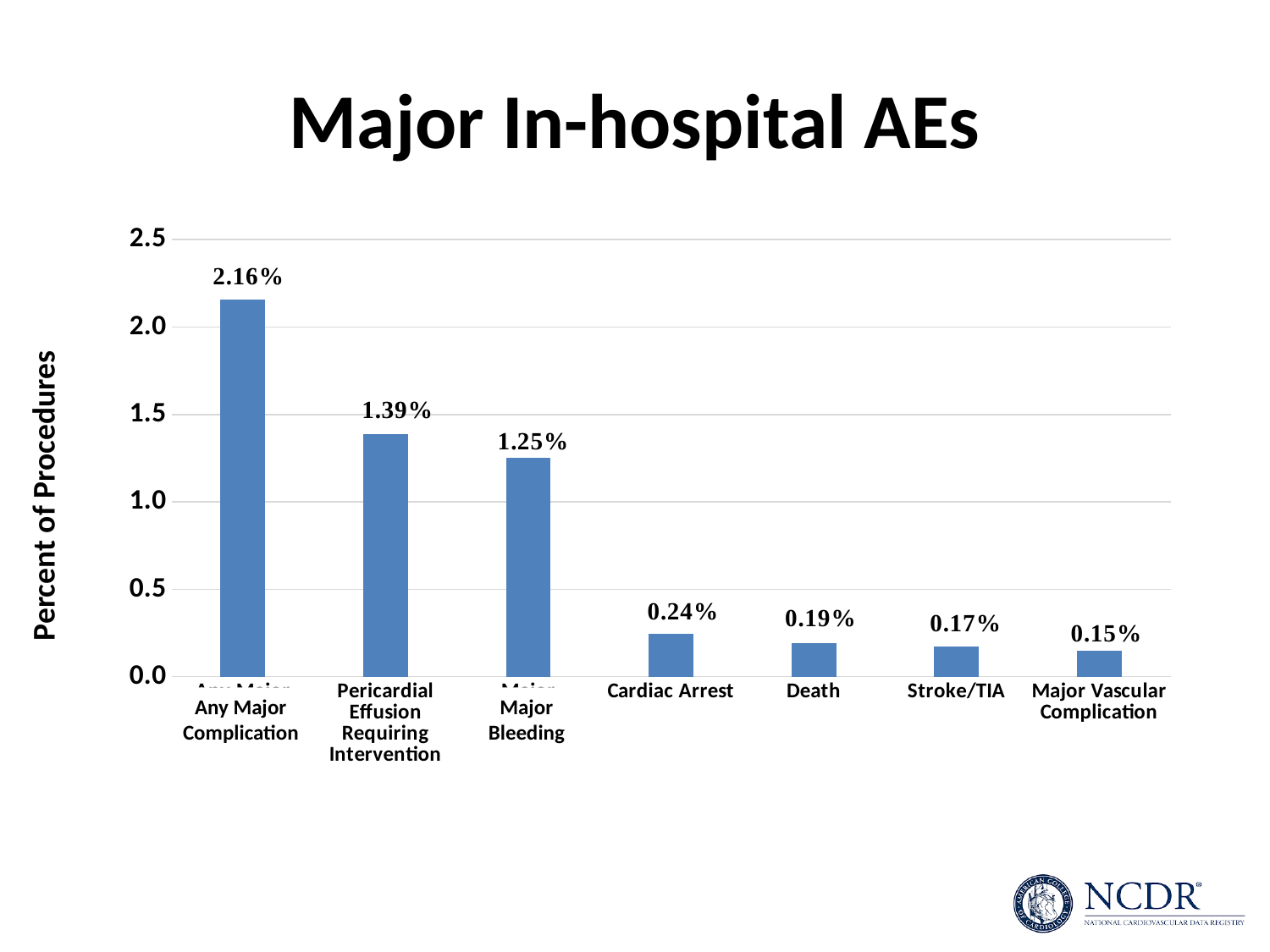
What is the label of the y axis? Percent of Procedures What is the value for Death? 0.19% Which is larger, the value for Cardiac Arrest or the value for Death? Cardiac Arrest Is the value for Major Bleeding greater or less than 1.0? greater Which category has the highest value? Any Major Complication What is the value for Pericardial Effusion Requiring Intervention? 1.39% Which category has the lowest value? Major Vascular Complication How many categories are shown on the x axis? 7 What is the difference between the values for Any Major Complication and Major Bleeding? 0.91% What kind of chart is shown on the slide? Bar chart What is the value for Stroke/TIA? 0.17% What is the value for Any Major Complication? 2.16%